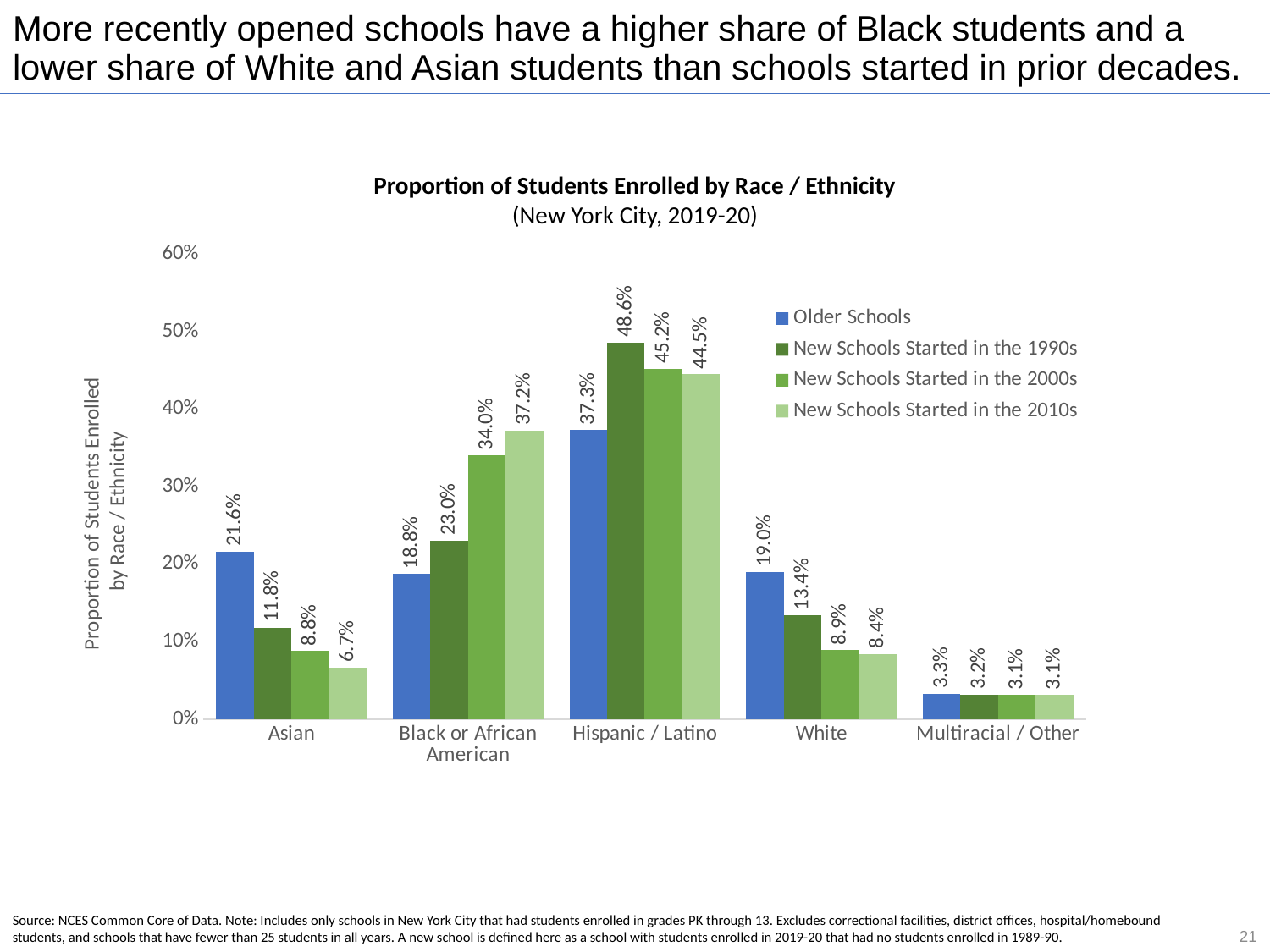
What is the title of the chart? Proportion of Students Enrolled by Race / Ethnicity (New York City, 2019-20) How many series does the legend list? 4 What is the proportion of White students in New Schools Started in the 2000s? 8.9% Which race / ethnicity category has the lowest proportion for New Schools Started in the 2010s? Multiracial / Other What is the proportion of Hispanic / Latino students in New Schools Started in the 1990s? 48.6% What kind of chart is shown on the slide? Bar chart What is the proportion of Black or African American students in New Schools Started in the 2010s? 37.2% What is the proportion of Asian students in Older Schools? 21.6% Which race / ethnicity category has the highest proportion for Older Schools? Hispanic / Latino How many race / ethnicity categories are shown on the x axis? 5 What is the difference between the proportion of Black or African American students in New Schools Started in the 2010s and in Older Schools? 18.4 percentage points Which is larger: the proportion of White students in Older Schools or the proportion of Asian students in Older Schools? Asian students in Older Schools